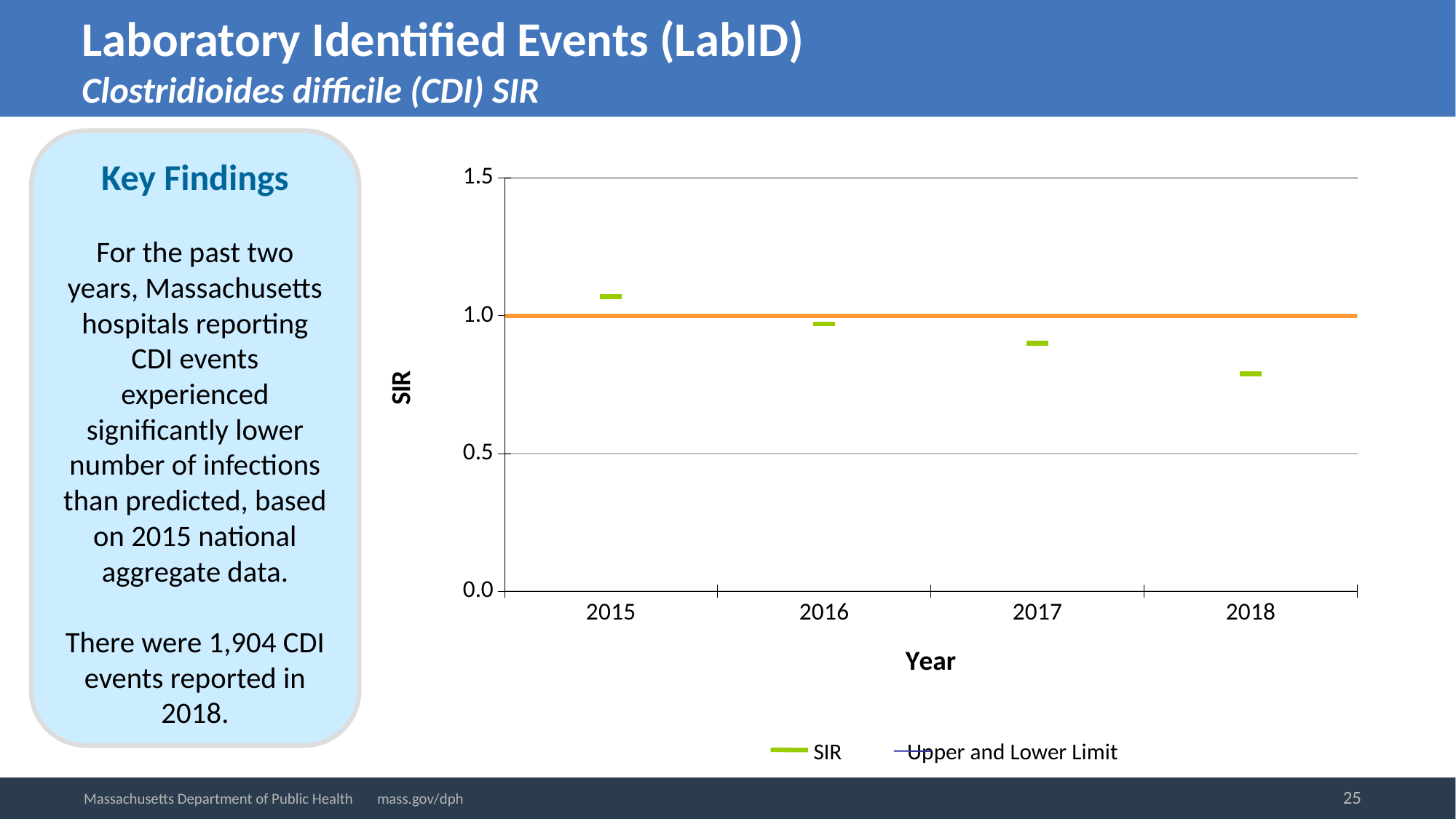
Is the SIR value for 2017 greater or less than 1.0? less Which year has a larger SIR value, 2015 or 2018? 2015 Which year has the highest SIR value on the chart? 2015 Which year has the lowest SIR value on the chart? 2018 Is the SIR value for 2018 greater or less than 0.5? greater Do the SIR values rise or fall from 2015 to 2018? fall What is the title of the x axis of the chart? Year Is the SIR value for 2018 greater or less than 1.0? less Which year has a larger SIR value, 2017 or 2018? 2017 How many years are shown on the x axis of the chart? 4 How many series does the chart legend list? 2